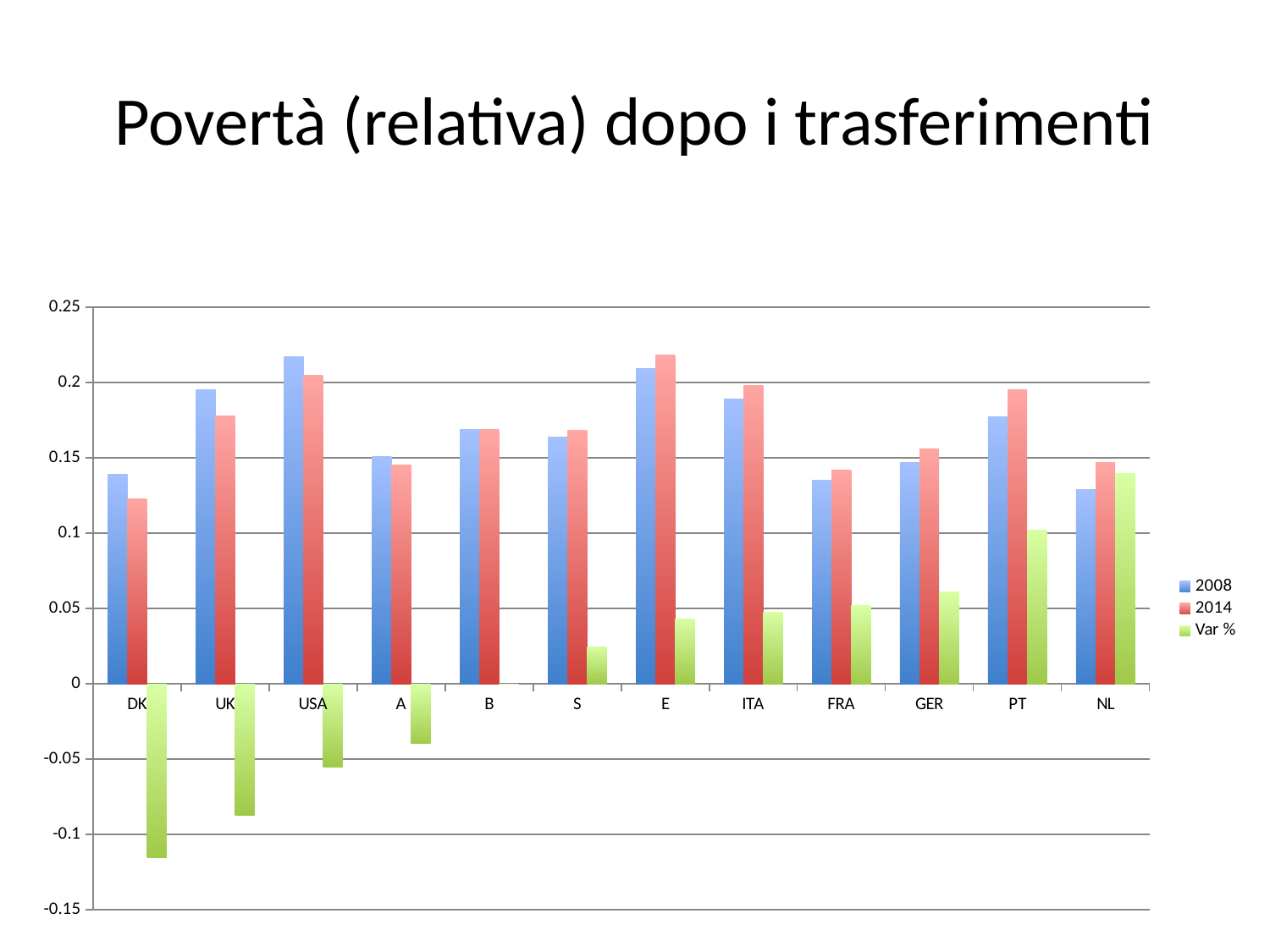
Which country has the highest value for the 2014 series? E What is the title of the chart on the slide? Povertà (relativa) dopo i trasferimenti Is the 2008 value for USA greater or less than 0.2? greater What kind of chart is shown on the slide? bar chart How many series does the legend list? 3 Which country has the highest value for the Var % series? NL Is the 2008 value for DK greater or less than 0.15? less Which country has the lowest value for the Var % series? DK How many countries are shown on the x axis? 12 Which country has the lowest value for the 2014 series? DK For UK, which is larger: the 2008 value or the 2014 value? 2008 Is the Var % value for UK greater or less than -0.05? less